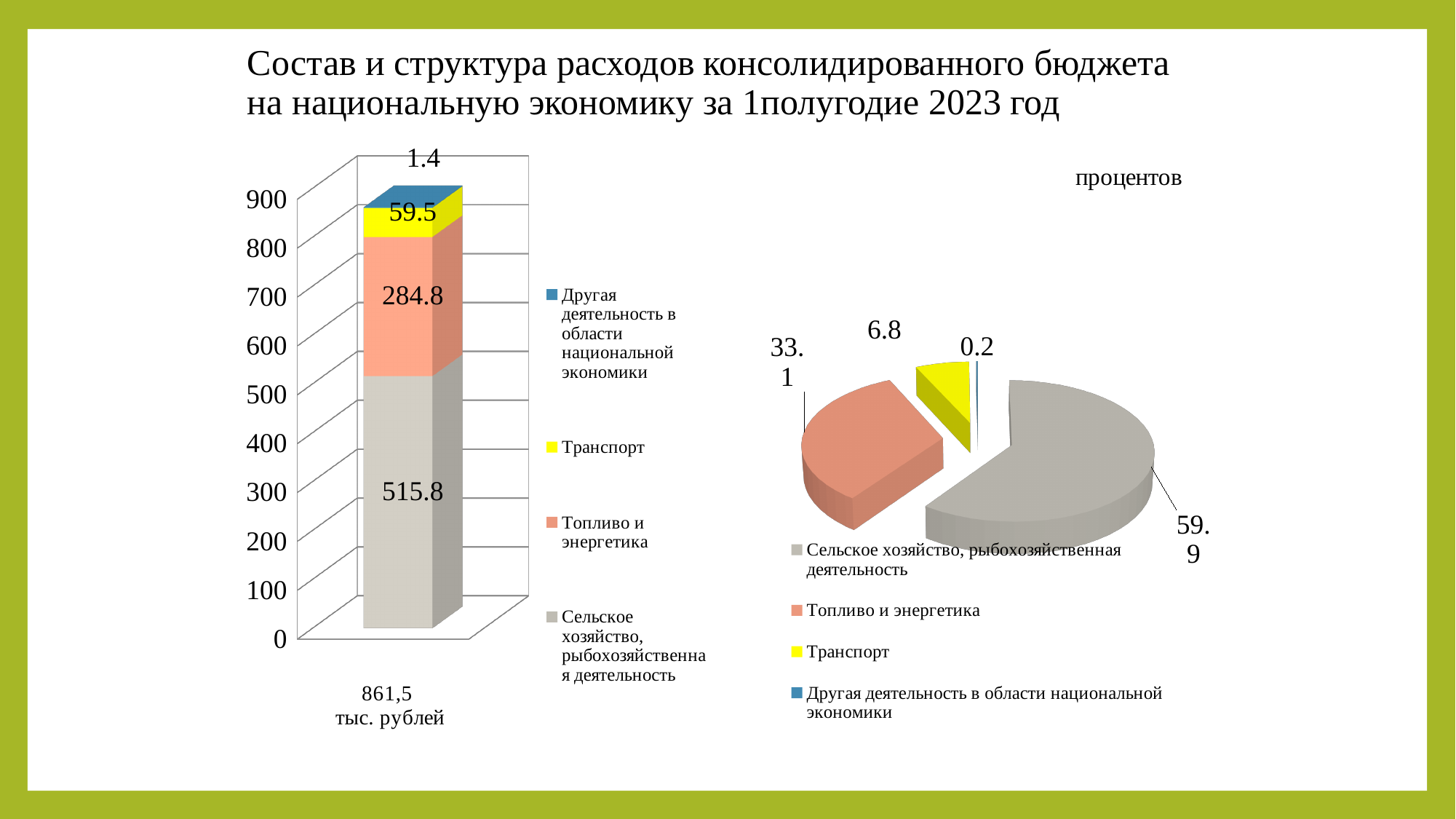
What kind of chart is shown on the right side of the slide? Pie chart On the stacked bar chart on the left, what is the value for Сельское хозяйство, рыбохозяйственная деятельность? 515.8 On the stacked bar chart on the left, which series has the smallest value? Другая деятельность в области национальной экономики On the stacked bar chart on the left, what is the value for Транспорт? 59.5 On the pie chart on the right, which category has the largest slice? Сельское хозяйство, рыбохозяйственная деятельность On the stacked bar chart on the left, what is the value for Топливо и энергетика? 284.8 On the pie chart on the right, what share does Сельское хозяйство, рыбохозяйственная деятельность have? 59.9 On the pie chart on the right, which is larger: Топливо и энергетика or Транспорт? Топливо и энергетика On the stacked bar chart on the left, how many series does the legend list? 4 On the pie chart on the right, what share does Транспорт have? 6.8 On the stacked bar chart on the left, what total is printed below the bar? 861,5 тыс. рублей On the stacked bar chart on the left, what is the difference between the values for Сельское хозяйство, рыбохозяйственная деятельность and Топливо и энергетика? 231.0